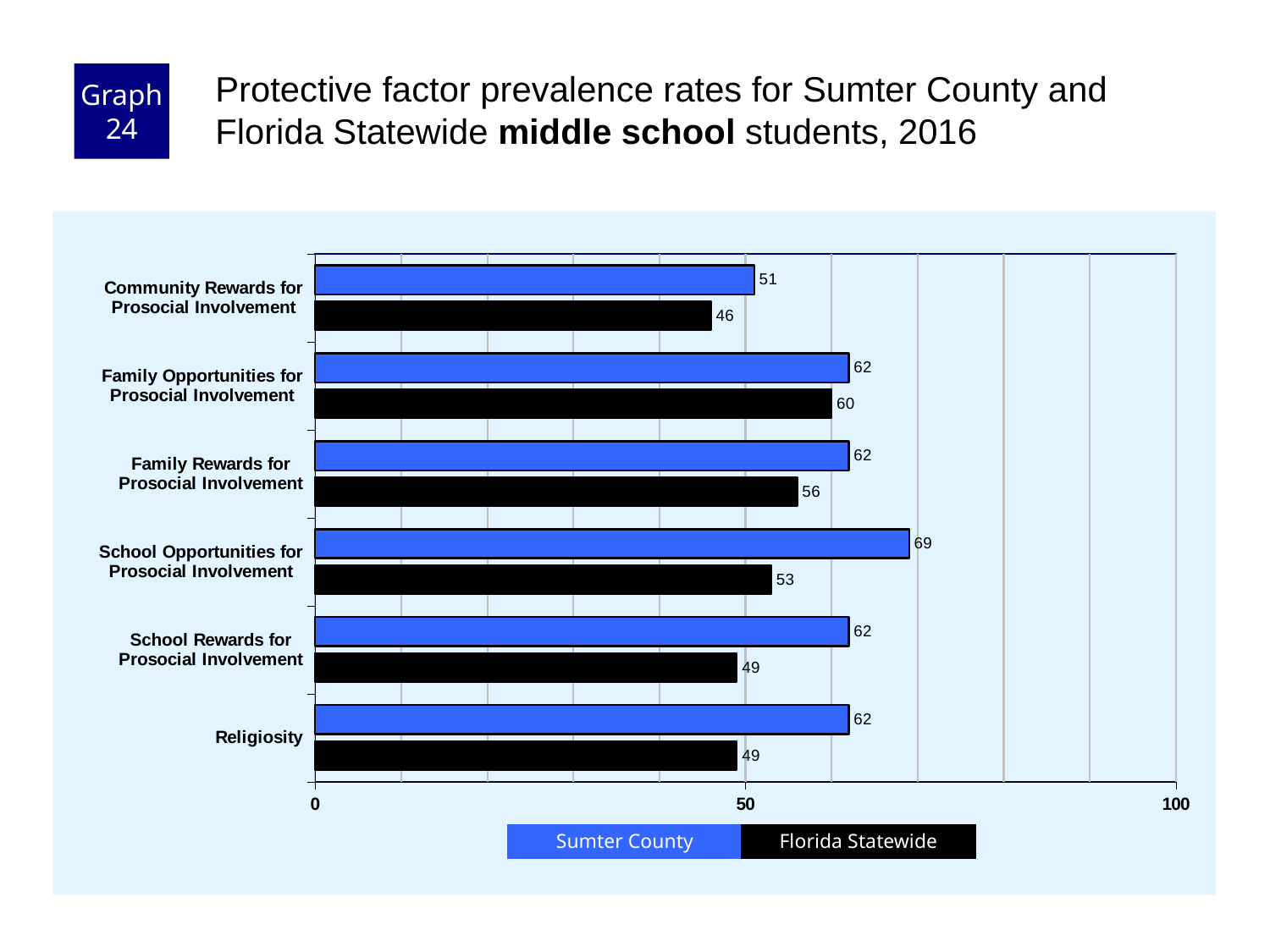
Which category has the highest Sumter County value? School Opportunities for Prosocial Involvement Which category has the lowest Florida Statewide value? Community Rewards for Prosocial Involvement What is the Florida Statewide value for Family Rewards for Prosocial Involvement? 56 What is the difference between the Sumter County and Florida Statewide values for Religiosity? 13 What is the difference between the Sumter County and Florida Statewide values for School Opportunities for Prosocial Involvement? 16 Which is larger for Family Opportunities for Prosocial Involvement: the Sumter County value or the Florida Statewide value? Sumter County Is the Florida Statewide value for Community Rewards for Prosocial Involvement greater or less than 50? less What is the Florida Statewide value for Community Rewards for Prosocial Involvement? 46 What is the Sumter County value for School Opportunities for Prosocial Involvement? 69 What kind of chart is shown on the slide? bar chart How many protective factor categories are shown on the chart? 6 How many series does the legend list? 2